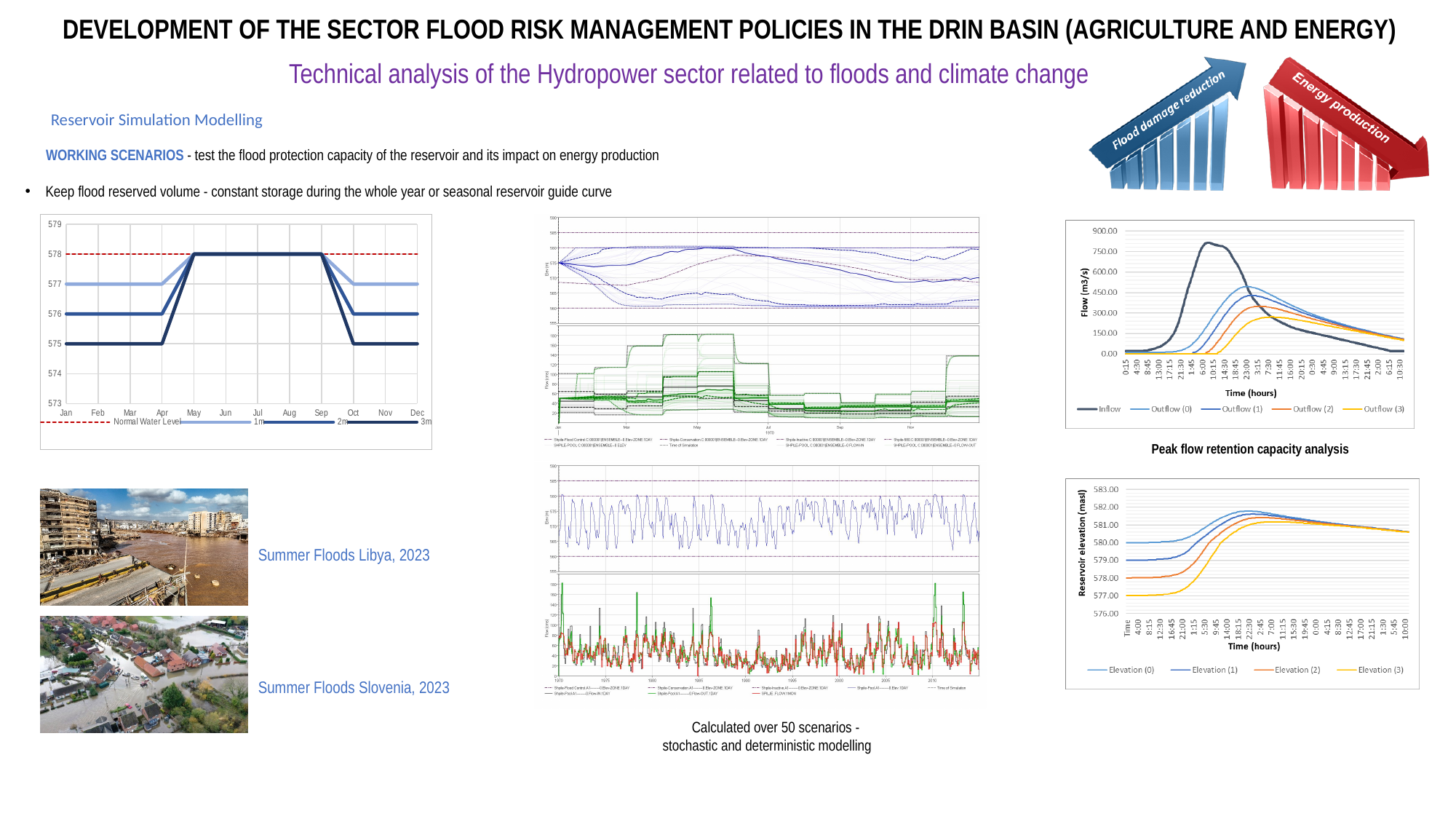
In the 'Peak flow retention capacity analysis' chart, is the peak value of Outflow (3) greater or less than 450.00? less In the 'Peak flow retention capacity analysis' chart, how many series does the legend list? 5 What kind of chart is the reservoir guide curve chart on the left of the slide (with months Jan to Dec on the x axis)? line chart In the 'Peak flow retention capacity analysis' chart, which series reaches the highest peak flow? Inflow In the reservoir guide curve chart on the left, how many months are shown on the x axis? 12 In the 'Peak flow retention capacity analysis' chart, is the peak value of Inflow greater or less than 600.00? greater In the reservoir elevation chart at the bottom right, which series starts at the lowest elevation? Elevation (3) In the reservoir elevation chart at the bottom right, how many series does the legend list? 4 In the reservoir guide curve chart on the left, at what level is the Normal Water Level dashed line drawn? 578 In the reservoir guide curve chart on the left, what is the value of the 1m line in Jan? 577 In the reservoir guide curve chart on the left, how many entries does the legend list? 4 In the reservoir guide curve chart on the left, what is the value of the 3m line in Jan? 575